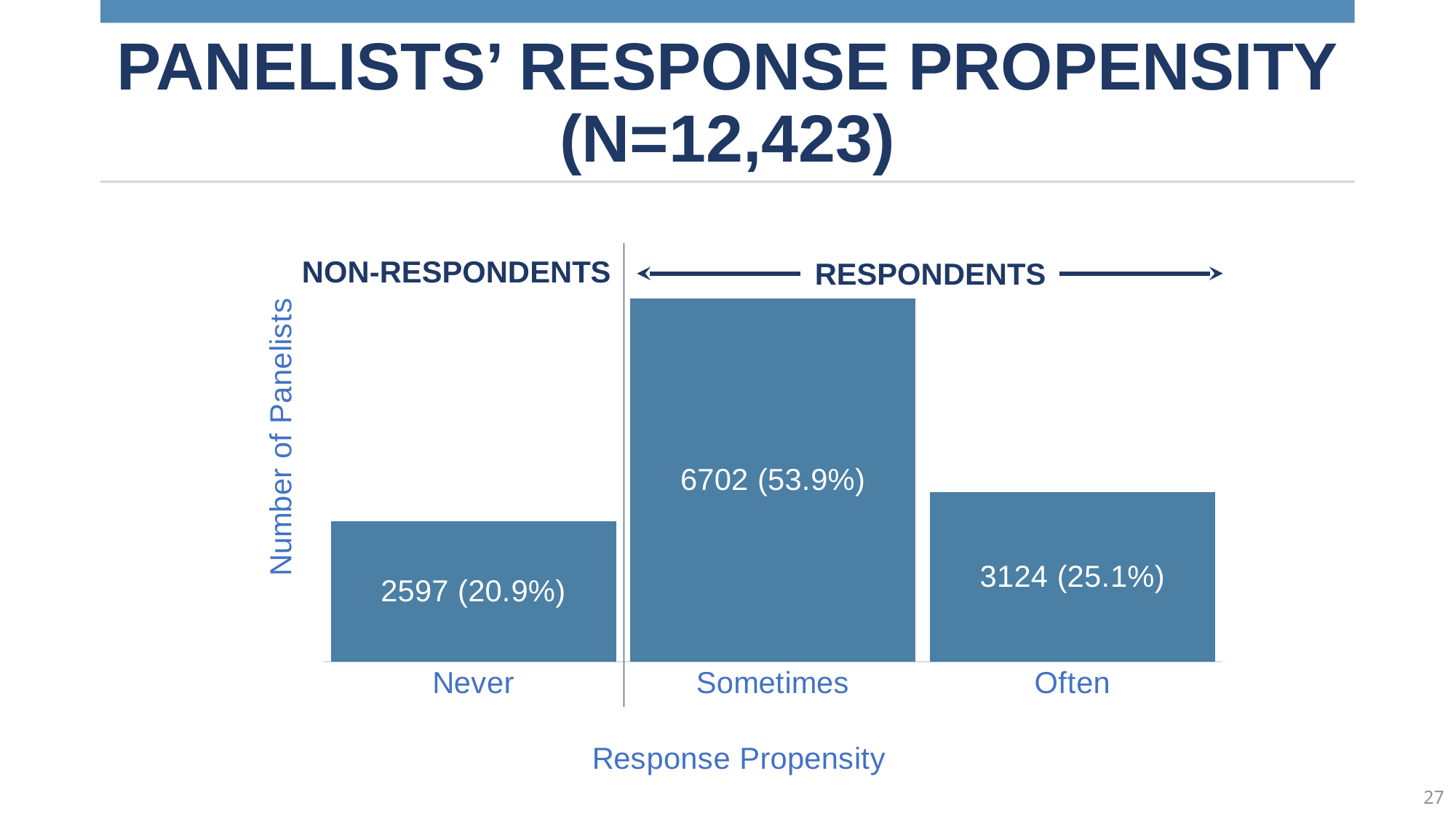
What kind of chart is shown on the slide? Bar chart Which has more panelists, Never or Often? Often What is the label of the y axis? Number of Panelists What is the difference in the number of panelists between Often and Never? 527 How many response propensity categories are shown on the chart? 3 What is the difference in the number of panelists between Sometimes and Often? 3578 What is the number of panelists in the Never category? 2597 Which categories are grouped under the RESPONDENTS heading? Sometimes and Often What percentage of panelists fall in the Often category? 25.1% Which response propensity category has the highest number of panelists? Sometimes Which response propensity category has the lowest number of panelists? Never What is the number of panelists in the Sometimes category? 6702